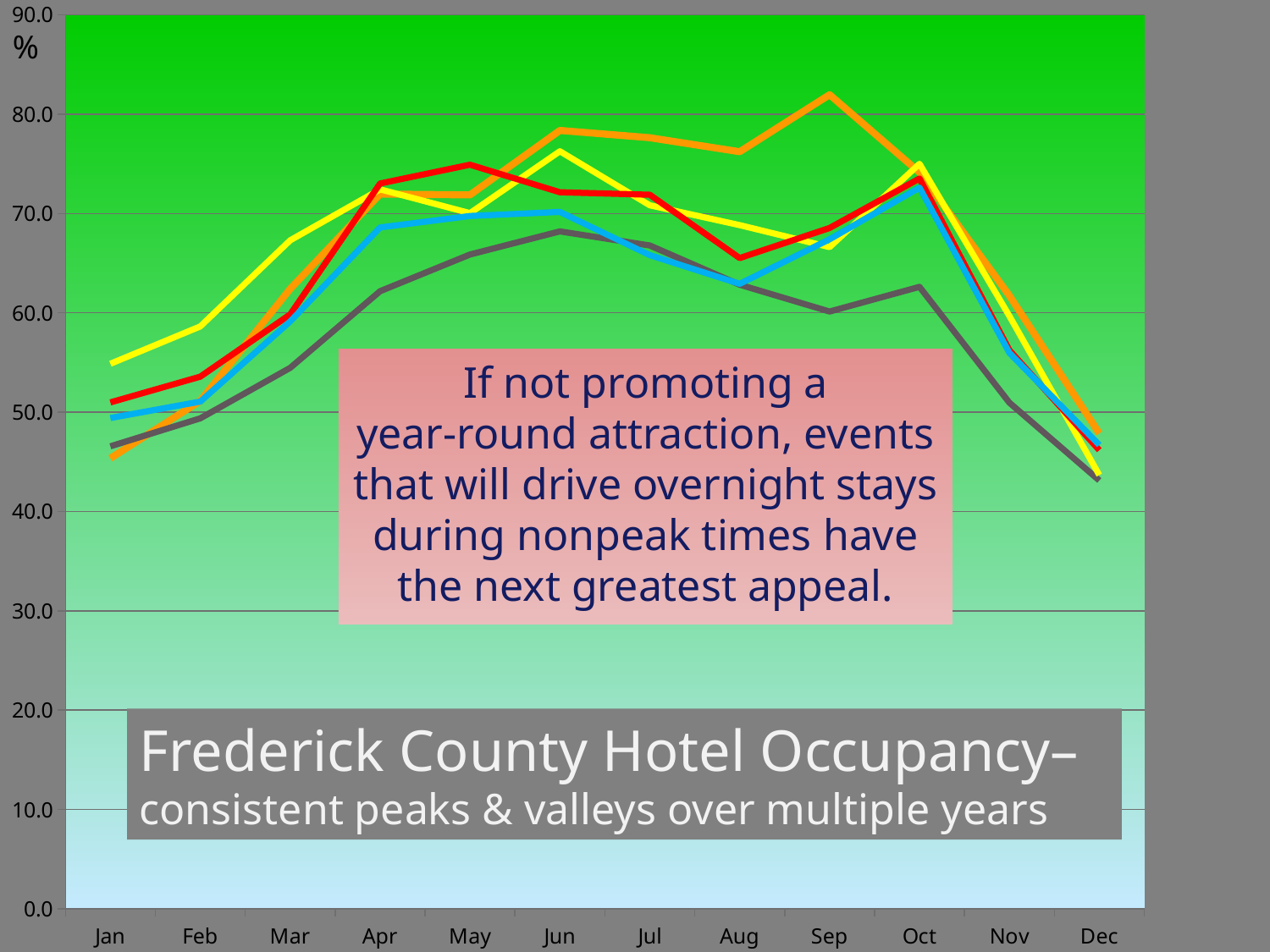
Do the lines generally rise or fall from Oct to Dec? fall How many months are shown along the x axis? 12 Is the orange line's value in Jan greater or less than 50? less In which month does the orange line reach its highest value? Sep What kind of chart is shown on the slide? line chart Is the gray line's value in Dec greater or less than 50? less What unit is shown on the y axis? % What is the title of the chart? Frederick County Hotel Occupancy– consistent peaks & valleys over multiple years In which month does the yellow line reach its lowest value? Dec Is the orange line's value in Sep greater or less than 80? greater In Sep, which is larger: the orange line or the gray line? orange line